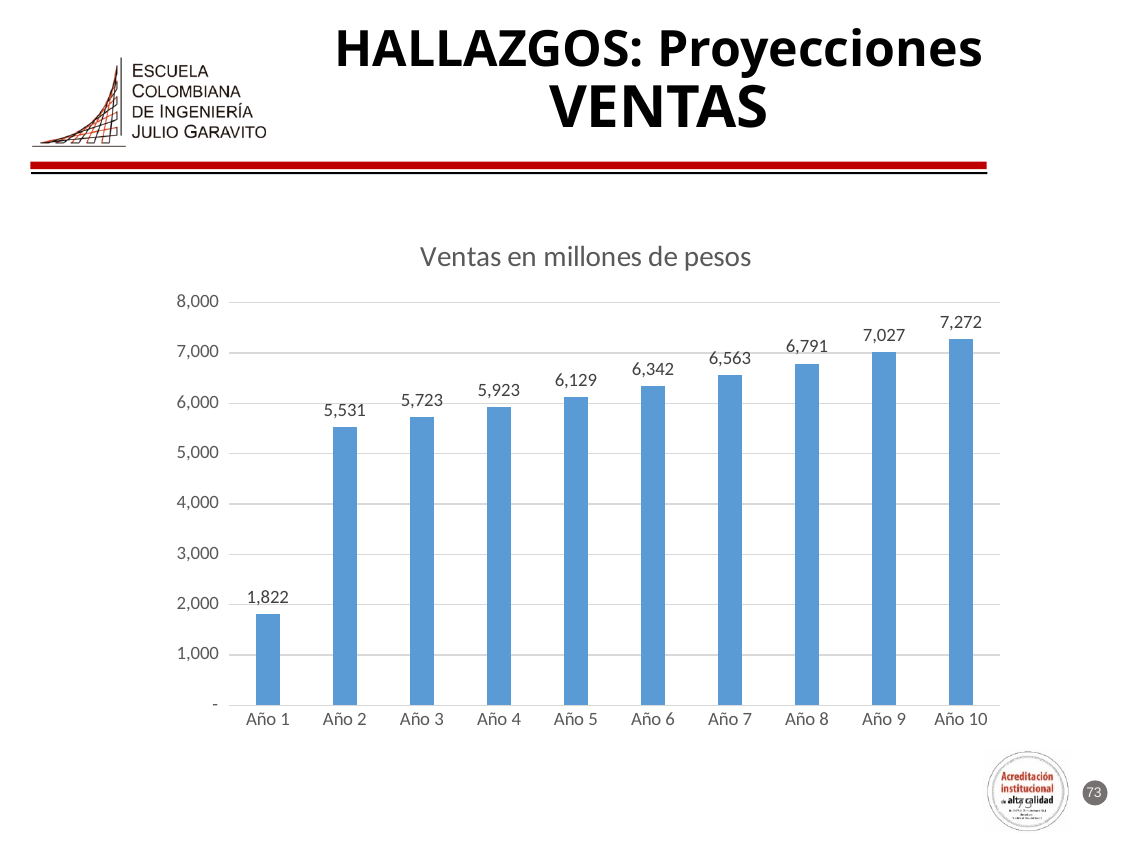
Which is larger, the value for Año 3 or the value for Año 7? Año 7 What is the difference between the values for Año 10 and Año 9? 245 Which year has the lowest value? Año 1 How many years are shown on the x axis? 10 Which year has the highest value? Año 10 What is the value for Año 1? 1,822 What is the value for Año 5? 6,129 What is the value for Año 10? 7,272 Do the values rise or fall from Año 1 to Año 10? rise What is the difference between the values for Año 2 and Año 1? 3,709 What kind of chart is shown? bar chart Is the value for Año 4 greater or less than 6,000? less